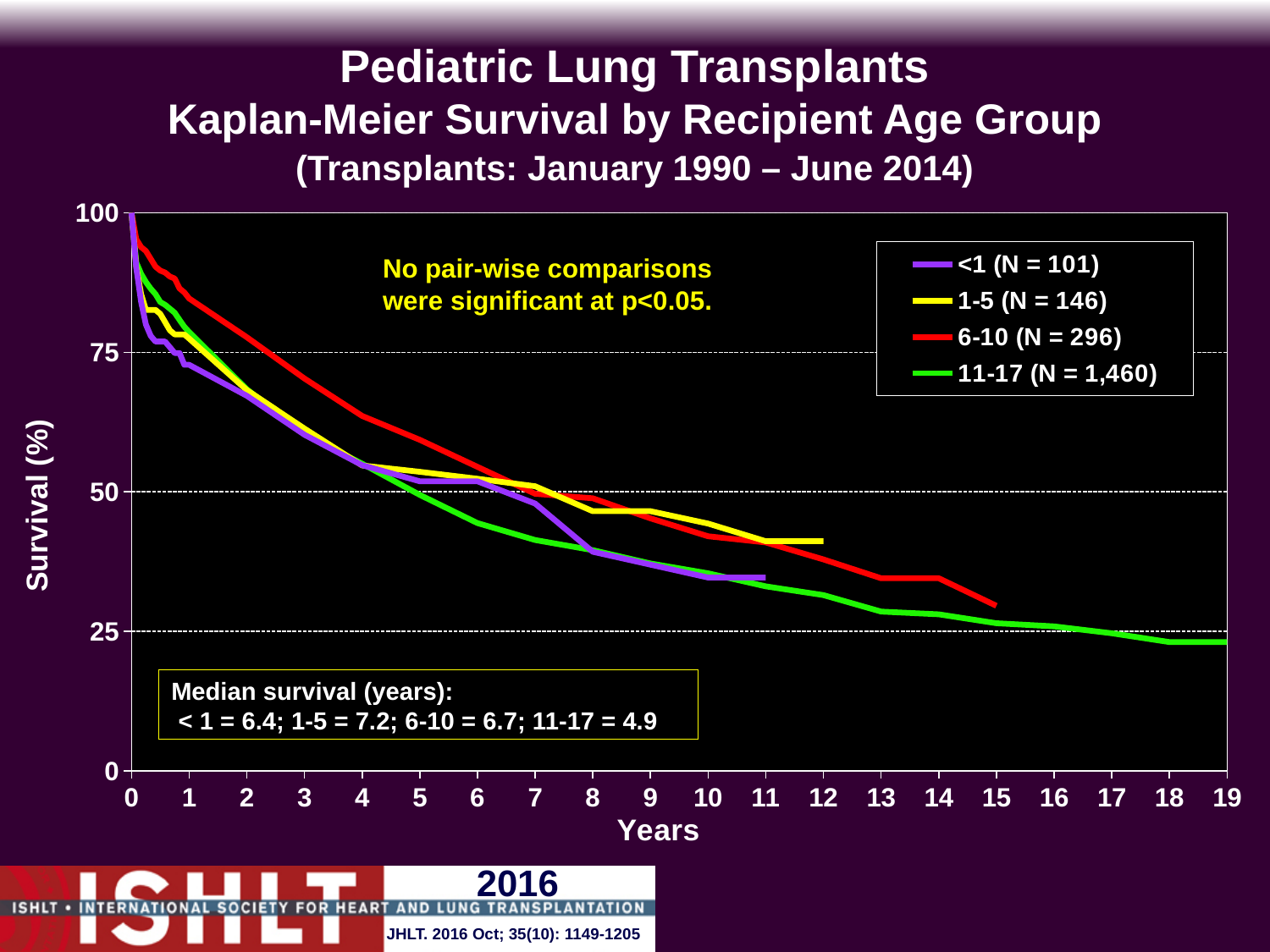
What is the median survival in years for the 11-17 age group? 4.9 What is the N for the 11-17 age group shown in the legend? 1,460 Do the survival curves rise or fall as years increase? fall Which age group has the lowest median survival? 11-17 What kind of chart is shown on the slide? line chart What is the median survival in years for the 1-5 age group? 7.2 How many recipient age groups does the legend list? 4 Which age group has the highest median survival? 1-5 At 5 years, which age group has higher survival: 6-10 or 11-17? 6-10 Is the survival for the 6-10 age group at 5 years greater or less than 50%? greater What is the difference in median survival (years) between the 1-5 and 11-17 age groups? 2.3 Is the survival for the 11-17 age group at 19 years greater or less than 25%? less